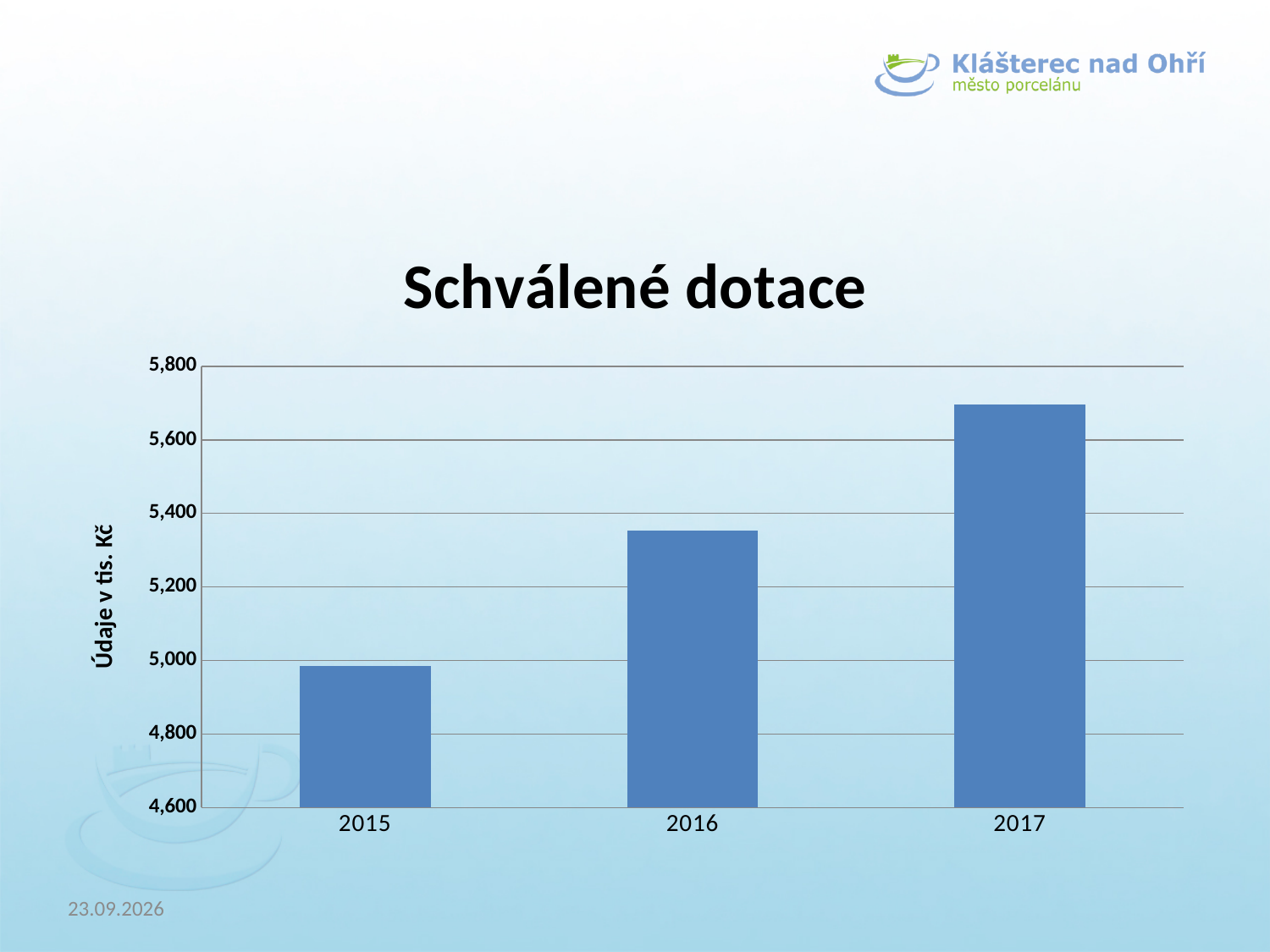
Which year has the highest value in the chart? 2017 What kind of chart is shown on the slide? bar chart Is the value for 2015 greater or less than 4,800? greater How many years are shown on the x axis of the chart? 3 What is the title of the chart? Schválené dotace Is the value for 2017 greater or less than 5,600? greater Do the values rise or fall from 2015 to 2017? rise What is the label on the vertical axis of the chart? Údaje v tis. Kč Which year has the lowest value in the chart? 2015 Which is larger, the value for 2016 or the value for 2017? 2017 Is the value for 2016 greater or less than 5,400? less